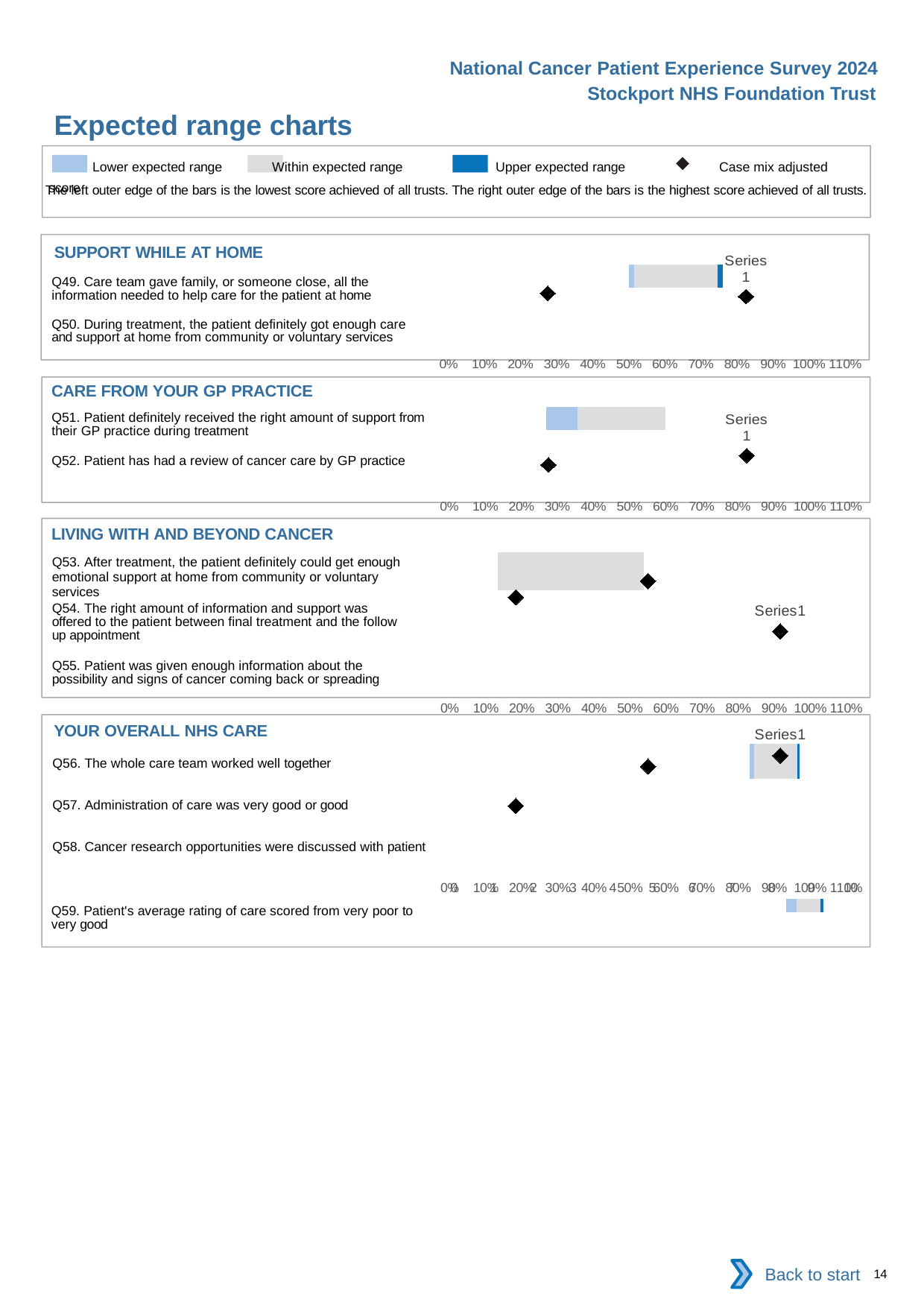
What kind of chart is used in the SUPPORT WHILE AT HOME section? Bar chart In the YOUR OVERALL NHS CARE chart, is the case mix adjusted score marker for Q57 greater or less than 40%? less Which legend entry is represented by a diamond marker? Case mix adjusted score How many questions are plotted in the LIVING WITH AND BEYOND CANCER chart? 3 How many entries does the legend at the top of the slide list? 4 How many section charts are shown on the slide? 4 What is the highest tick shown on the x axis of the SUPPORT WHILE AT HOME chart? 110% In the SUPPORT WHILE AT HOME chart, is the case mix adjusted score marker for Q49 greater or less than 50%? less How many questions are listed in the YOUR OVERALL NHS CARE section? 4 In the CARE FROM YOUR GP PRACTICE chart, is the case mix adjusted score marker for Q52 greater or less than 50%? less